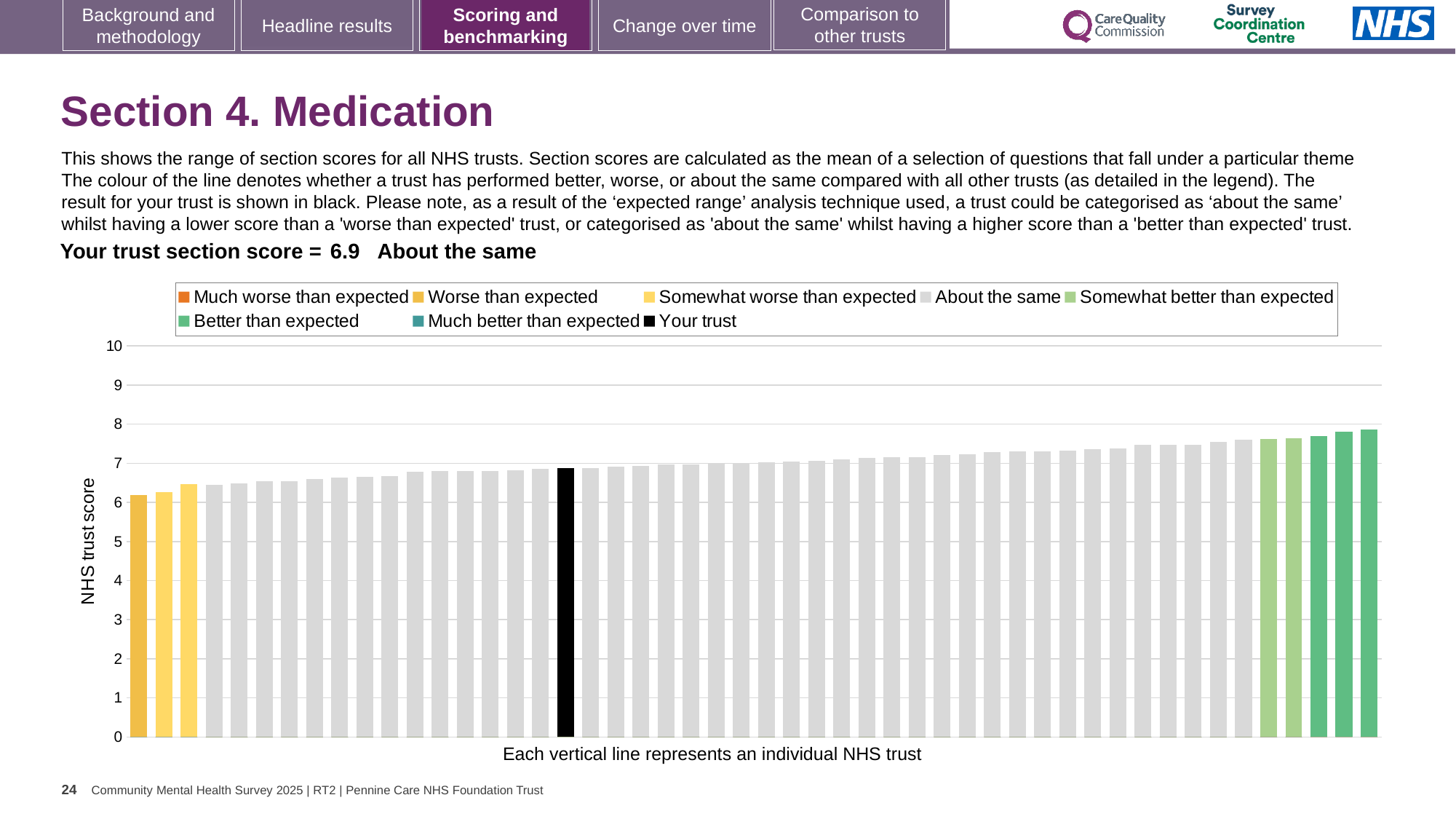
How many entries does the chart legend list? 8 Is the value of the tallest bar (rightmost) greater or less than 8? less Is the value of the black 'Your trust' bar greater or less than 7? less What is the section score for your trust shown on the slide? 6.9 What is the label on the vertical axis of the chart? NHS trust score Do the bar values rise or fall from left to right along the x axis? rise Is the value of the shortest bar (leftmost) greater or less than 7? less Which performance category is your trust placed in for Section 4. Medication? About the same What kind of chart is shown on the slide? bar chart